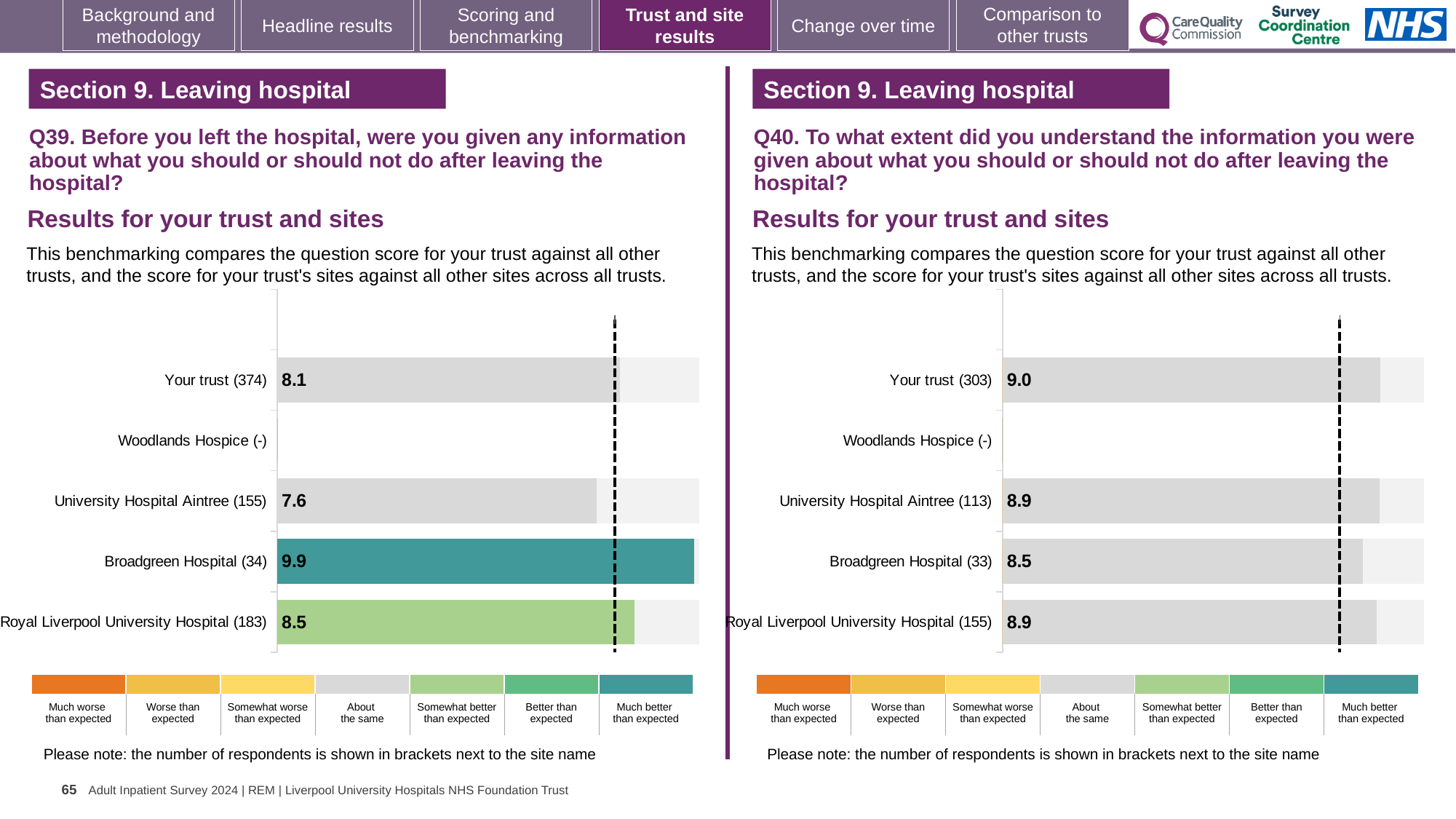
In the Q39 chart on the left, which site has the lowest score? University Hospital Aintree In the Q40 chart on the right, how many sites or trust rows are listed on the vertical axis? 5 In the Q39 chart on the left, what is the score for Broadgreen Hospital? 9.9 In the Q40 chart on the right, what is the score for Your trust? 9.0 In the Q40 chart on the right, what is the score for Broadgreen Hospital? 8.5 In the Q40 chart on the right, is the score for Your trust larger or smaller than the score for Broadgreen Hospital? larger In the Q39 chart on the left, what is the score for University Hospital Aintree? 7.6 In the Q39 chart on the left, which site has the highest score? Broadgreen Hospital In the Q39 chart on the left, how many respondents are shown for Royal Liverpool University Hospital? 183 What type of chart is used for the Q39 results on the left? bar chart In the Q40 chart on the right, which site has the lowest score? Broadgreen Hospital In the Q39 chart on the left, what is the difference between the scores for Broadgreen Hospital and Your trust? 1.8